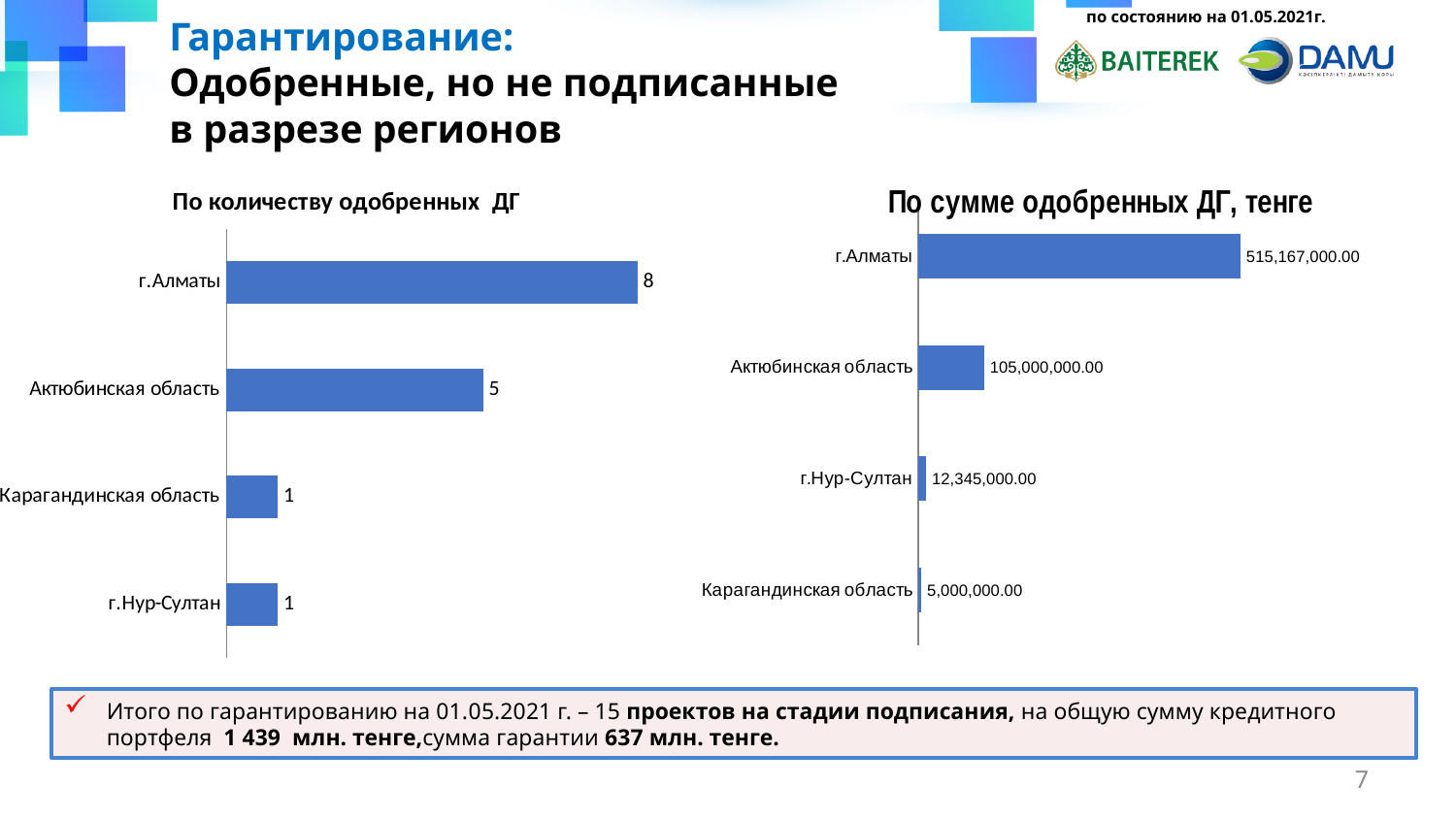
In the chart 'По сумме одобренных ДГ, тенге', what is the value for г.Алматы? 515,167,000.00 In the chart 'По сумме одобренных ДГ, тенге', which is larger: Актюбинская область or г.Нур-Султан? Актюбинская область In the chart 'По количеству одобренных ДГ', what is the difference between г.Алматы and Актюбинская область? 3 What is the title of the chart on the left side of the slide? По количеству одобренных ДГ In the chart 'По сумме одобренных ДГ, тенге', which region has the lowest value? Карагандинская область What type of chart is 'По сумме одобренных ДГ, тенге'? Bar chart In the chart 'По количеству одобренных ДГ', what is the value for Актюбинская область? 5 In the chart 'По сумме одобренных ДГ, тенге', what is the difference between г.Алматы and Актюбинская область? 410,167,000.00 In the chart 'По количеству одобренных ДГ', what is the value for г.Алматы? 8 In the chart 'По количеству одобренных ДГ', which region has the highest value? г.Алматы In the chart 'По сумме одобренных ДГ, тенге', what is the value for г.Нур-Султан? 12,345,000.00 In the chart 'По количеству одобренных ДГ', how many regions are shown? 4